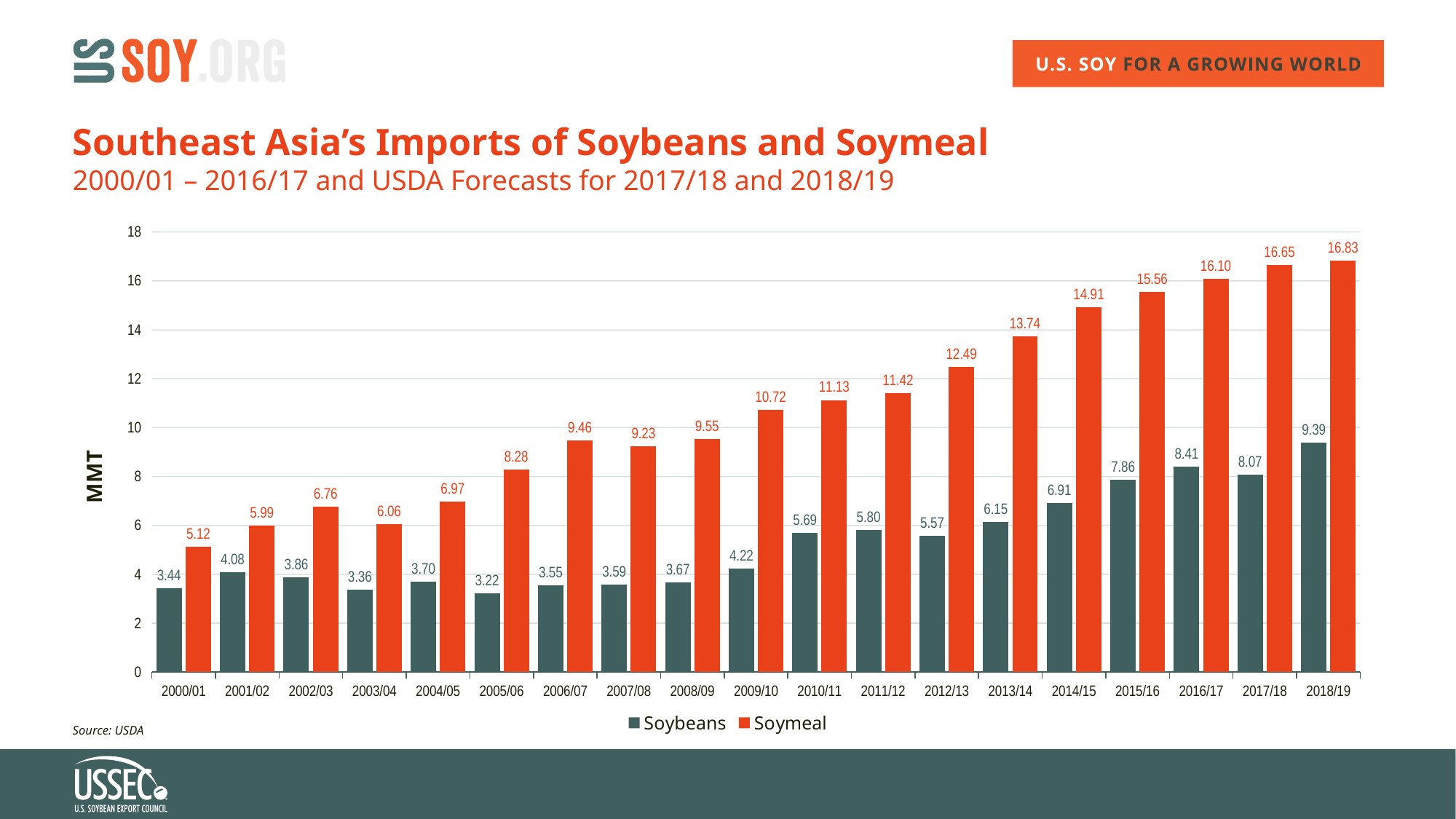
How many years are shown on the x axis? 19 Which is larger, the Soybeans value in 2015/16 or the Soybeans value in 2017/18? 2017/18 Is the Soymeal value for 2012/13 greater or less than 12? greater Which year has the highest Soymeal import value? 2018/19 What kind of chart is shown on the slide? Bar chart What is the Soymeal import value for 2018/19? 16.83 What is the difference between the Soymeal and Soybeans values in 2016/17? 7.69 What unit is shown on the y axis label? MMT How many series does the legend list? 2 Which year has the lowest Soybeans import value? 2005/06 What is the Soybeans import value for 2009/10? 4.22 Do the Soymeal values generally rise or fall from 2000/01 to 2018/19? Rise